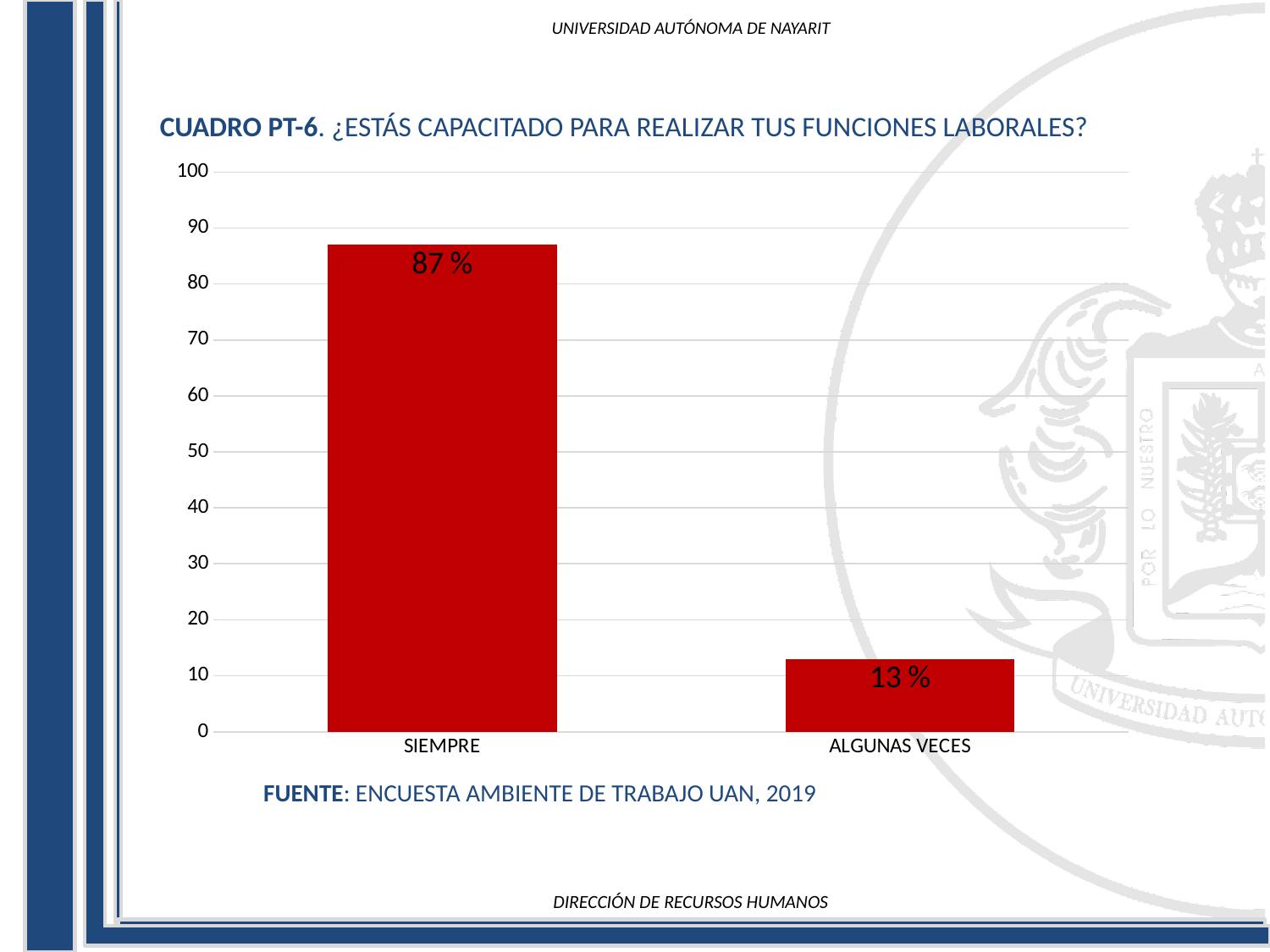
Is the value for SIEMPRE greater or less than 80? greater What is the highest value shown on the vertical axis? 100 Which is larger, the value for SIEMPRE or the value for ALGUNAS VECES? SIEMPRE What kind of chart is shown on the slide? bar chart What is the value for SIEMPRE? 87 % How many categories are shown on the x axis? 2 Which category has the highest value? SIEMPRE Is the value for ALGUNAS VECES greater or less than 20? less What is the source cited below the chart? ENCUESTA AMBIENTE DE TRABAJO UAN, 2019 Which category has the lowest value? ALGUNAS VECES What is the difference between the values for SIEMPRE and ALGUNAS VECES? 74 % What is the value for ALGUNAS VECES? 13 %